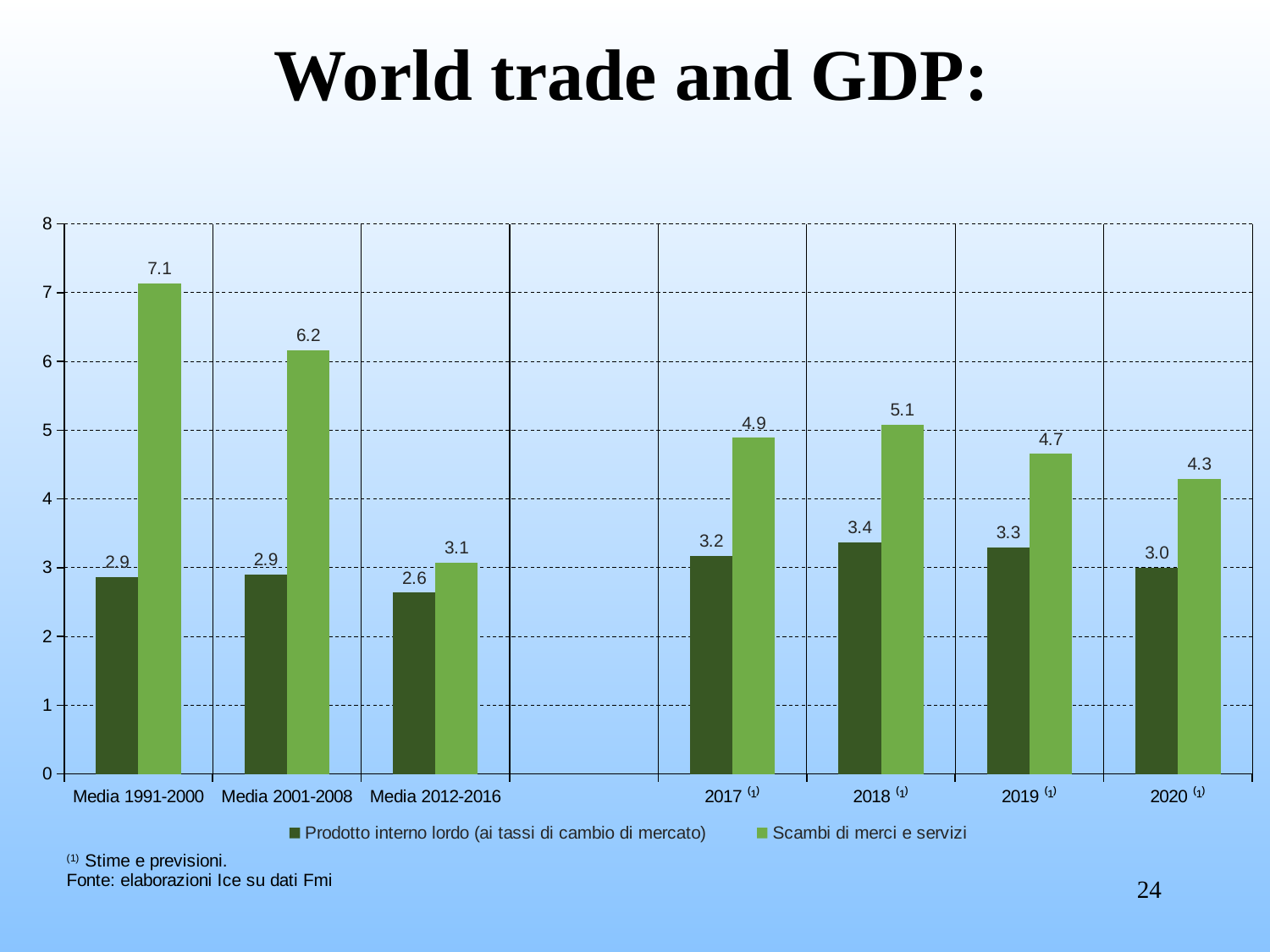
How many categories are shown on the x axis? 7 What is the value of Scambi di merci e servizi for 2020? 4.3 Which category has the lowest value for Prodotto interno lordo (ai tassi di cambio di mercato)? Media 2012-2016 Which is larger for 2019: Prodotto interno lordo or Scambi di merci e servizi? Scambi di merci e servizi What kind of chart is shown on the slide? Bar chart How many series does the legend list? 2 What is the value of Prodotto interno lordo (ai tassi di cambio di mercato) for 2018? 3.4 What is the difference between Scambi di merci e servizi and Prodotto interno lordo for Media 2001-2008? 3.3 What is the value of Scambi di merci e servizi for Media 1991-2000? 7.1 What is the title of the slide? World trade and GDP: Do the values for Scambi di merci e servizi rise or fall from 2018 to 2020? Fall Which category has the highest value for Scambi di merci e servizi? Media 1991-2000